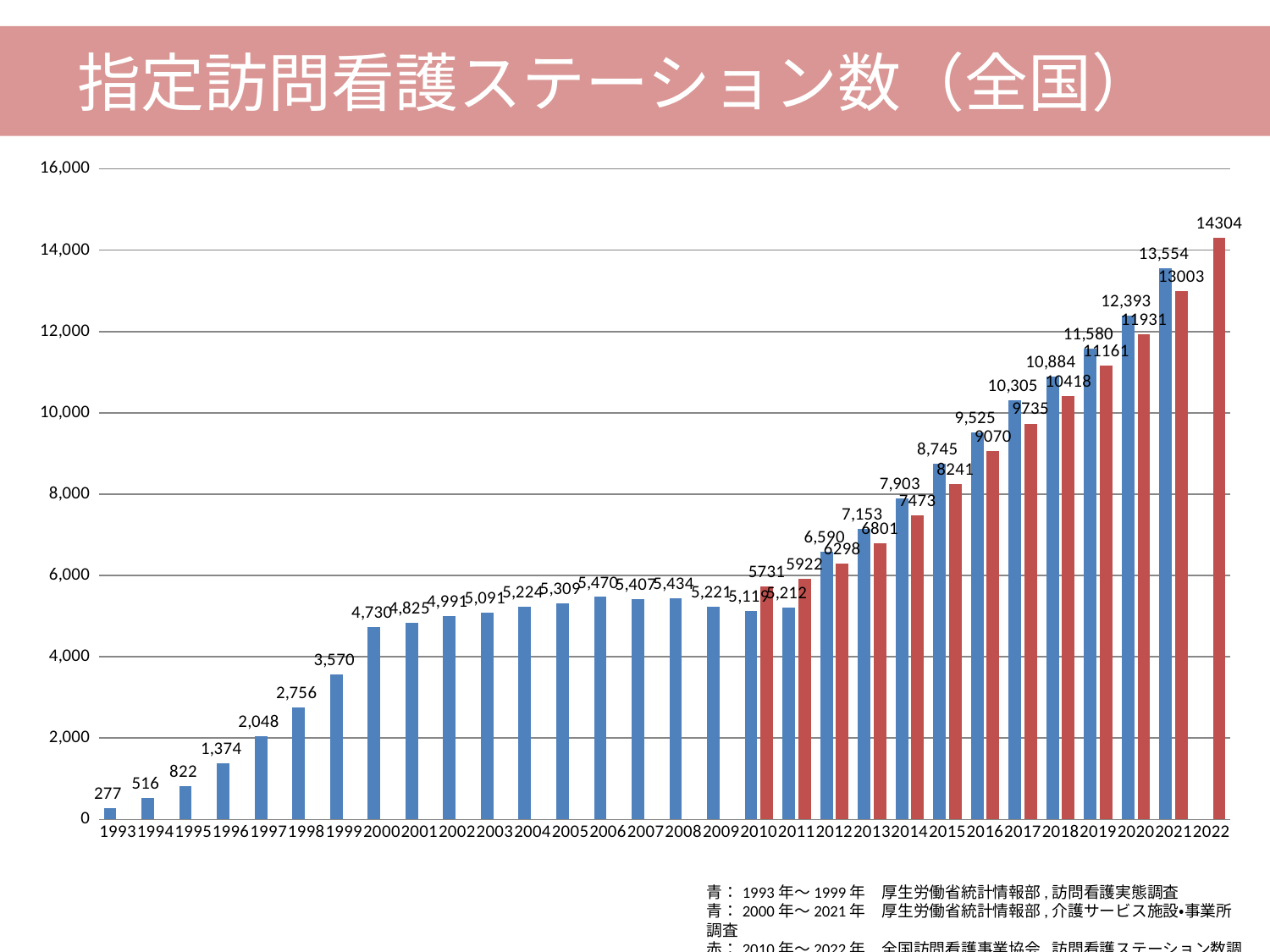
What is the value of the red bar for 2022? 14304 What is the value of the blue bar for 1993? 277 What is the title of the chart? 指定訪問看護ステーション数（全国） What is the difference between the blue bar values for 2021 and 2020? 1,161 Which year has the tallest blue bar? 2021 What is the value of the blue bar for 1999? 3,570 What is the value of the red bar for 2015? 8241 How many years are shown on the x axis? 30 In 2012, which is larger: the blue bar or the red bar? The blue bar Which year has the lowest value on the chart? 1993 What is the difference between the red bar values for 2022 and 2021? 1301 What kind of chart is shown on the slide? Bar chart